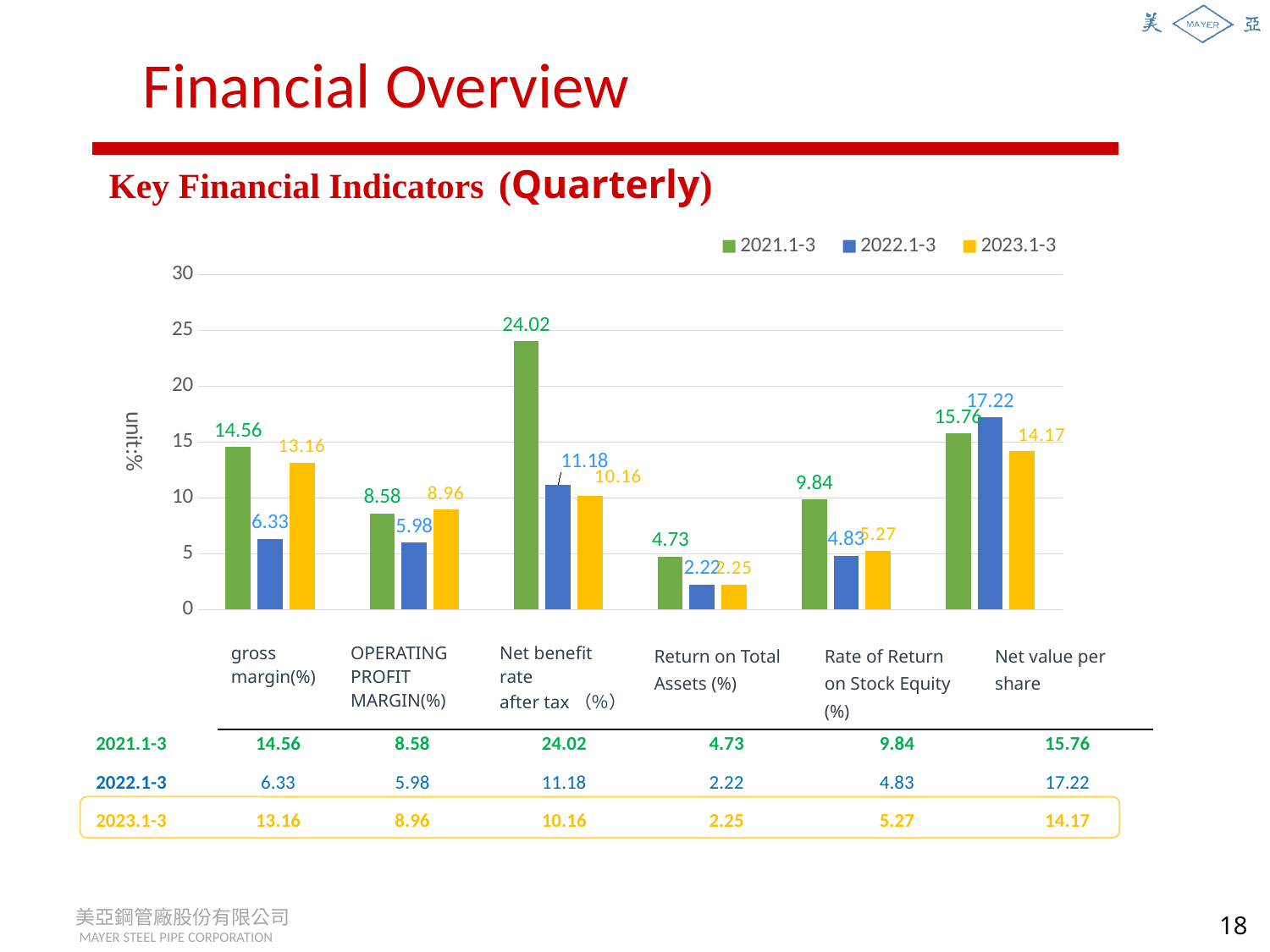
Which category has the highest value in the 2021.1-3 series? Net benefit rate after tax (%) Is the 2021.1-3 value for Rate of Return on Stock Equity (%) greater or less than 10? less Which is larger for OPERATING PROFIT MARGIN(%): the 2021.1-3 value or the 2023.1-3 value? 2023.1-3 What is the value for Net benefit rate after tax (%) in the 2023.1-3 series? 10.16 What is the difference between the 2021.1-3 and 2023.1-3 values for Net benefit rate after tax (%)? 13.86 How many series does the legend list? 3 What is the value for Net value per share in the 2022.1-3 series? 17.22 What unit is shown on the vertical axis label? unit:% What is the value for gross margin(%) in the 2021.1-3 series? 14.56 How many categories are shown on the x axis? 6 What kind of chart is shown on the slide? bar chart Which category has the lowest value in the 2022.1-3 series? Return on Total Assets (%)